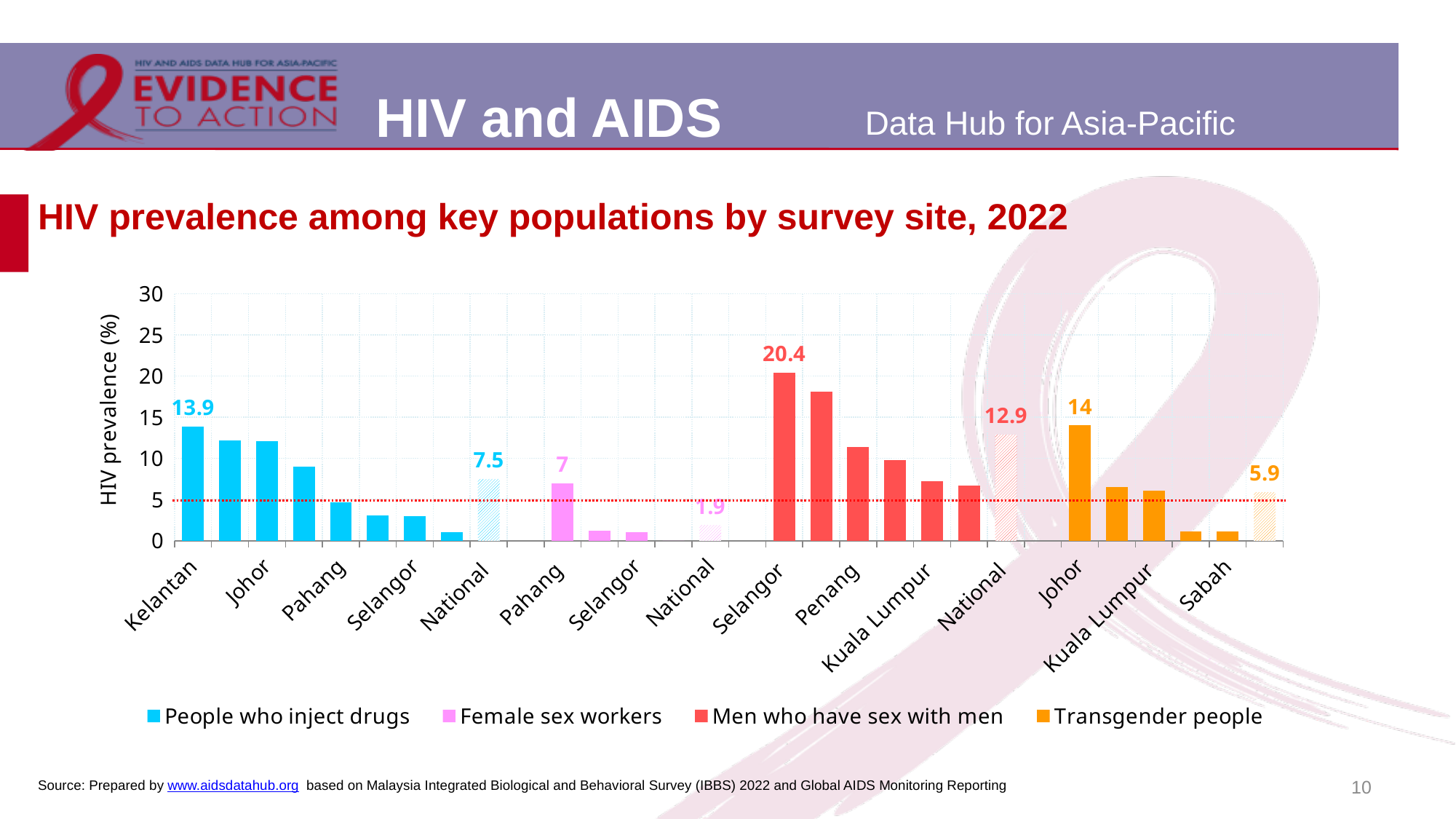
What is the HIV prevalence among transgender people in Johor? 14 What is the difference between the HIV prevalence among men who have sex with men in Selangor and among people who inject drugs in Kelantan? 6.5 Which is larger: the HIV prevalence among female sex workers in Pahang or the national value for people who inject drugs? National value for people who inject drugs How many series does the legend list? 4 What is the national HIV prevalence among men who have sex with men? 12.9 What kind of chart is shown on the slide? Bar chart What is the difference between the HIV prevalence among transgender people in Johor and the national value for transgender people? 8.1 Which survey site and key population has the highest HIV prevalence on the chart? Selangor, men who have sex with men What is the HIV prevalence among men who have sex with men in Selangor? 20.4 Is the HIV prevalence among men who have sex with men in Penang greater or less than 10? greater What is the HIV prevalence among people who inject drugs in Kelantan? 13.9 What is the national HIV prevalence among female sex workers? 1.9